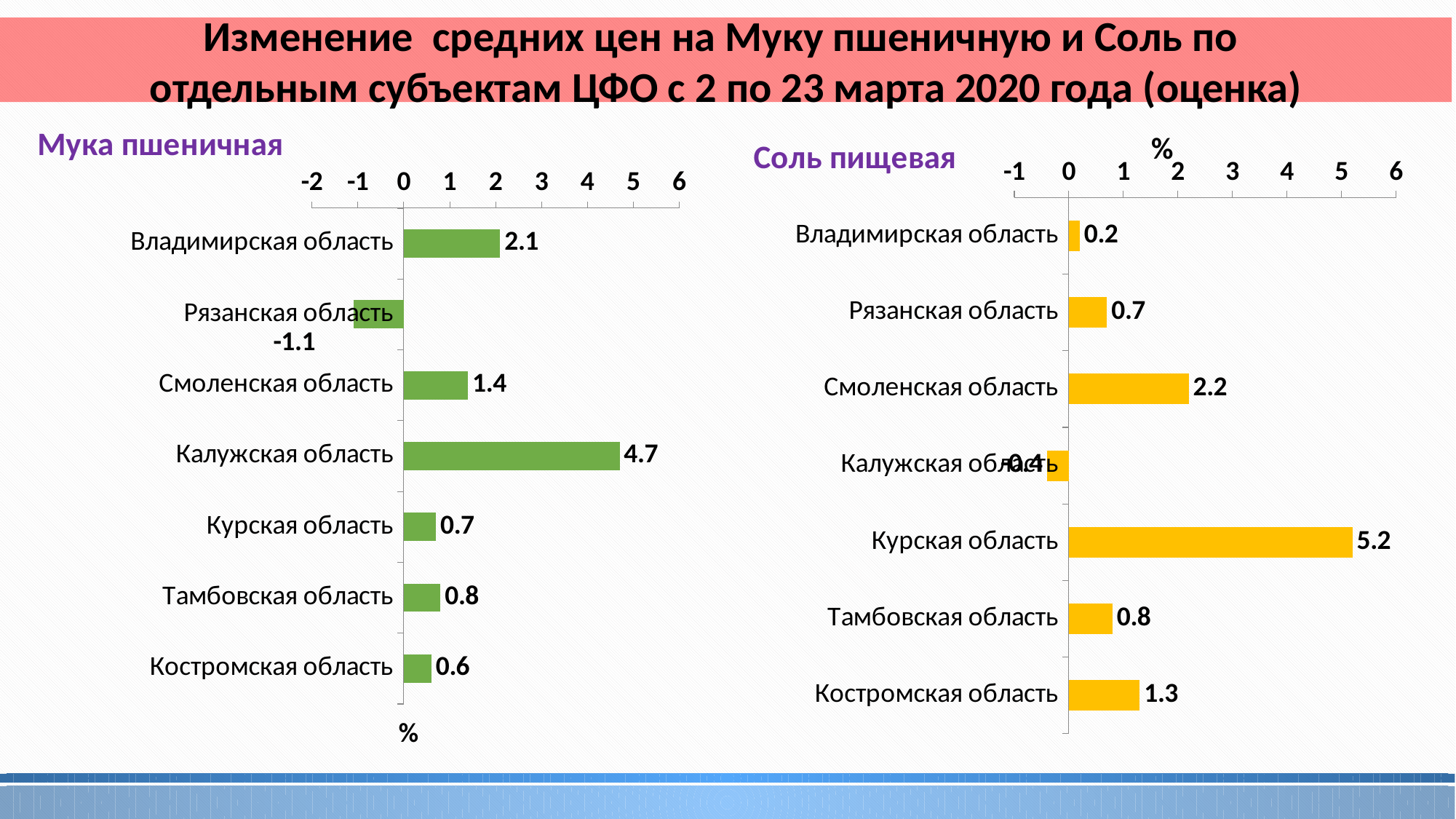
In the 'Мука пшеничная' chart, what is the value for Рязанская область? -1.1 In the 'Соль пищевая' chart, what is the value for Смоленская область? 2.2 In the 'Мука пшеничная' chart, which is larger: the value for Смоленская область or Тамбовская область? Смоленская область In the 'Соль пищевая' chart, what is the difference between the values for Курская область and Костромская область? 3.9 What type of chart is the 'Мука пшеничная' chart? Bar chart In the 'Соль пищевая' chart, which region has the lowest value? Калужская область How many regions are shown in the 'Соль пищевая' chart? 7 In the 'Соль пищевая' chart, what is the value for Курская область? 5.2 In the 'Мука пшеничная' chart, which region has the highest value? Калужская область What colour are the bars in the 'Соль пищевая' chart? Yellow In the 'Мука пшеничная' chart, what is the difference between the values for Калужская область and Владимирская область? 2.6 In the 'Мука пшеничная' chart, what is the value for Калужская область? 4.7